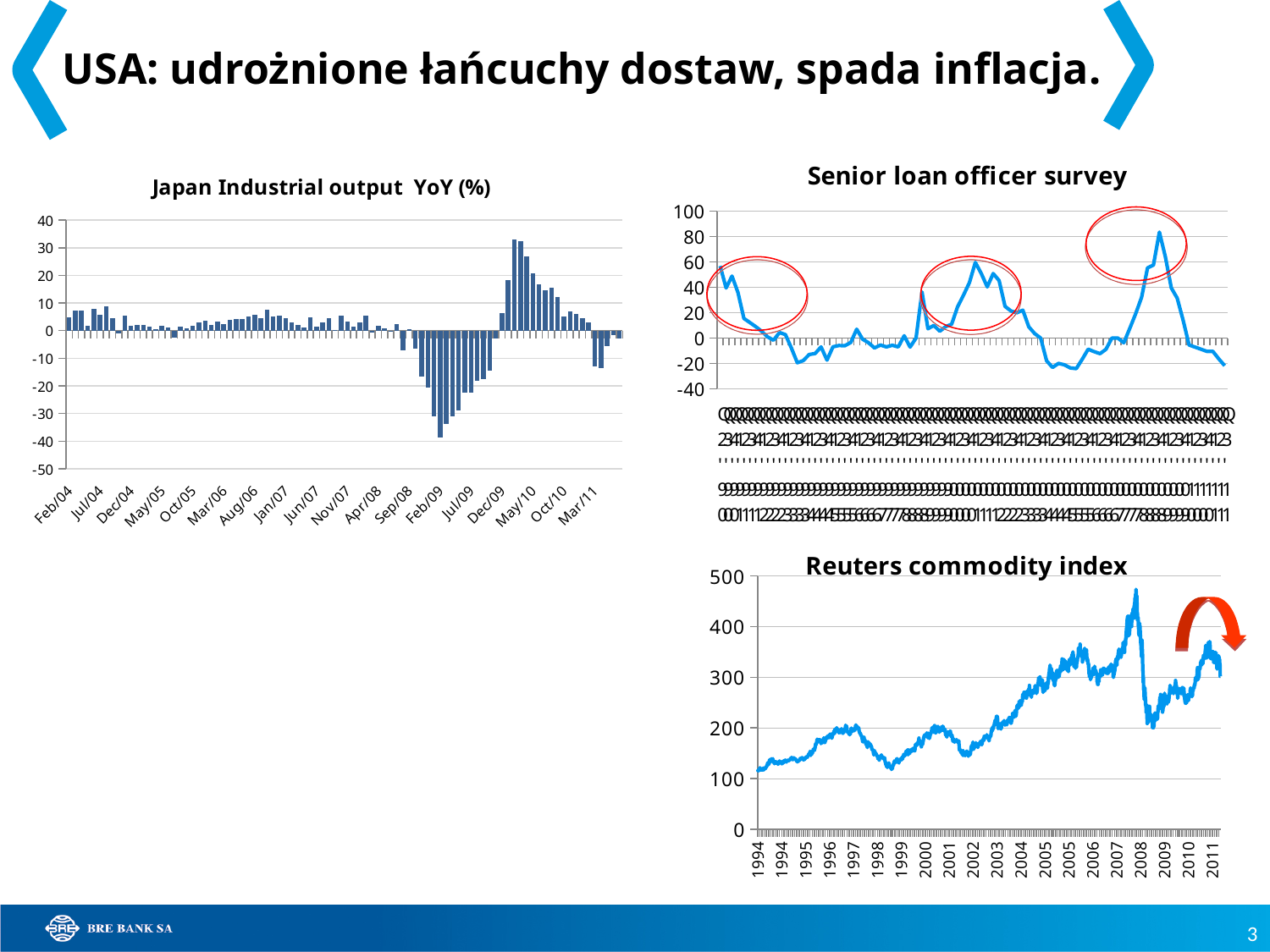
What kind of chart is the 'Reuters commodity index' chart? line chart What kind of chart is the 'Japan Industrial output YoY (%)' chart? bar chart How many red circles are drawn on the 'Senior loan officer survey' chart? 3 In the 'Japan Industrial output YoY (%)' chart, is the highest bar greater or less than 30? greater What kind of chart is the 'Senior loan officer survey' chart? line chart In the 'Japan Industrial output YoY (%)' chart, is the lowest bar greater or less than -30? less How many charts are shown on the slide? 3 In the 'Reuters commodity index' chart, is the value at the start of 1994 greater or less than 200? less In the 'Reuters commodity index' chart, does the index overall rise or fall from 1994 to 2008? rise What is the highest value shown on the y axis of the 'Reuters commodity index' chart? 500